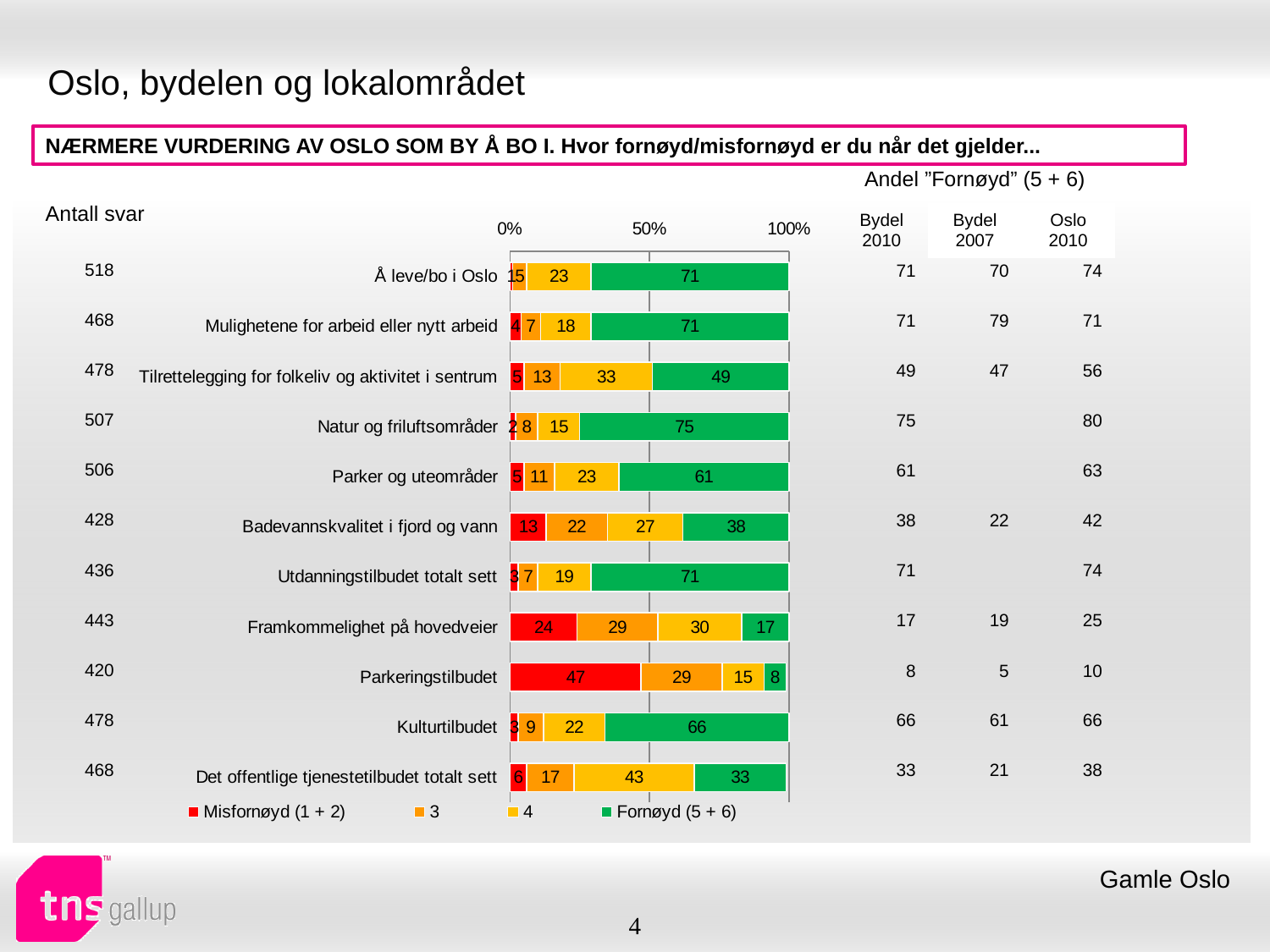
How many series does the legend list? 4 What kind of chart is shown on the slide? Stacked bar chart What is the Fornøyd (5 + 6) value for Natur og friluftsområder? 75 How many categories are shown in the chart? 11 What is the value of series 4 for Det offentlige tjenestetilbudet totalt sett? 43 What is the Misfornøyd (1 + 2) value for Parkeringstilbudet? 47 What is the total of the stacked bar for Framkommelighet på hovedveier? 100 What is the value of series 3 for Badevannskvalitet i fjord og vann? 22 Which category has the lowest Fornøyd (5 + 6) value? Parkeringstilbudet What is the difference between the Fornøyd (5 + 6) values for Natur og friluftsområder and Parkeringstilbudet? 67 Which category has the highest Fornøyd (5 + 6) value? Natur og friluftsområder Which has the larger Fornøyd (5 + 6) value: Badevannskvalitet i fjord og vann or Det offentlige tjenestetilbudet totalt sett? Badevannskvalitet i fjord og vann